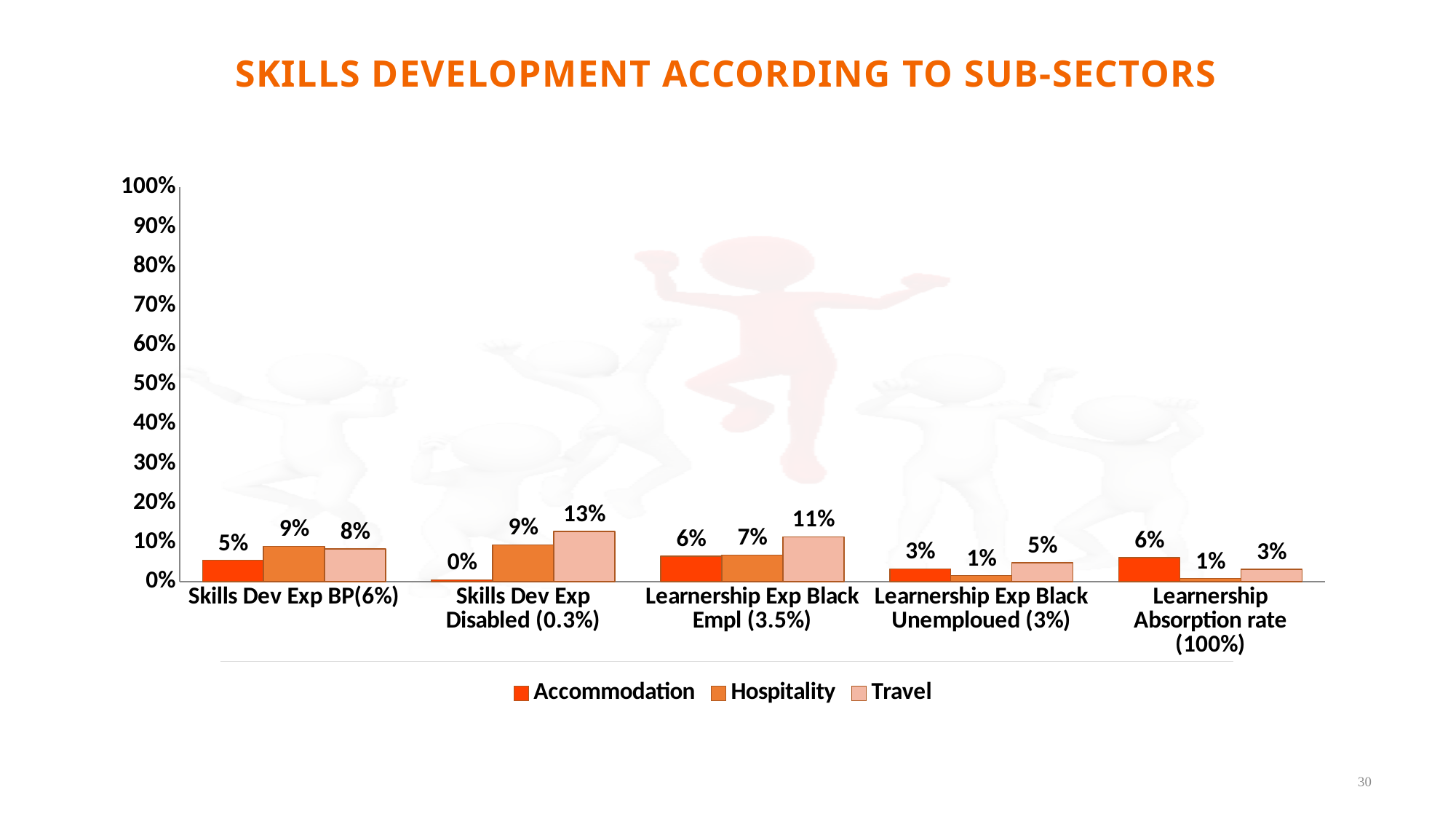
What kind of chart is shown on the slide? Bar chart What is the title of the chart? SKILLS DEVELOPMENT ACCORDING TO SUB-SECTORS What is the difference between the Travel and Accommodation values for Learnership Exp Black Empl (3.5%)? 5% What is the Travel value for Skills Dev Exp Disabled (0.3%)? 13% For Learnership Exp Black Unemploued (3%), which is larger: the Accommodation value or the Hospitality value? Accommodation What is the Accommodation value for Skills Dev Exp Disabled (0.3%)? 0% What is the Accommodation value for Learnership Exp Black Empl (3.5%)? 6% How many series does the legend list? 3 How many categories are shown on the x axis? 5 What is the Hospitality value for Learnership Absorption rate (100%)? 1% Which category has the lowest Accommodation value? Skills Dev Exp Disabled (0.3%) Which category has the highest Travel value? Skills Dev Exp Disabled (0.3%)